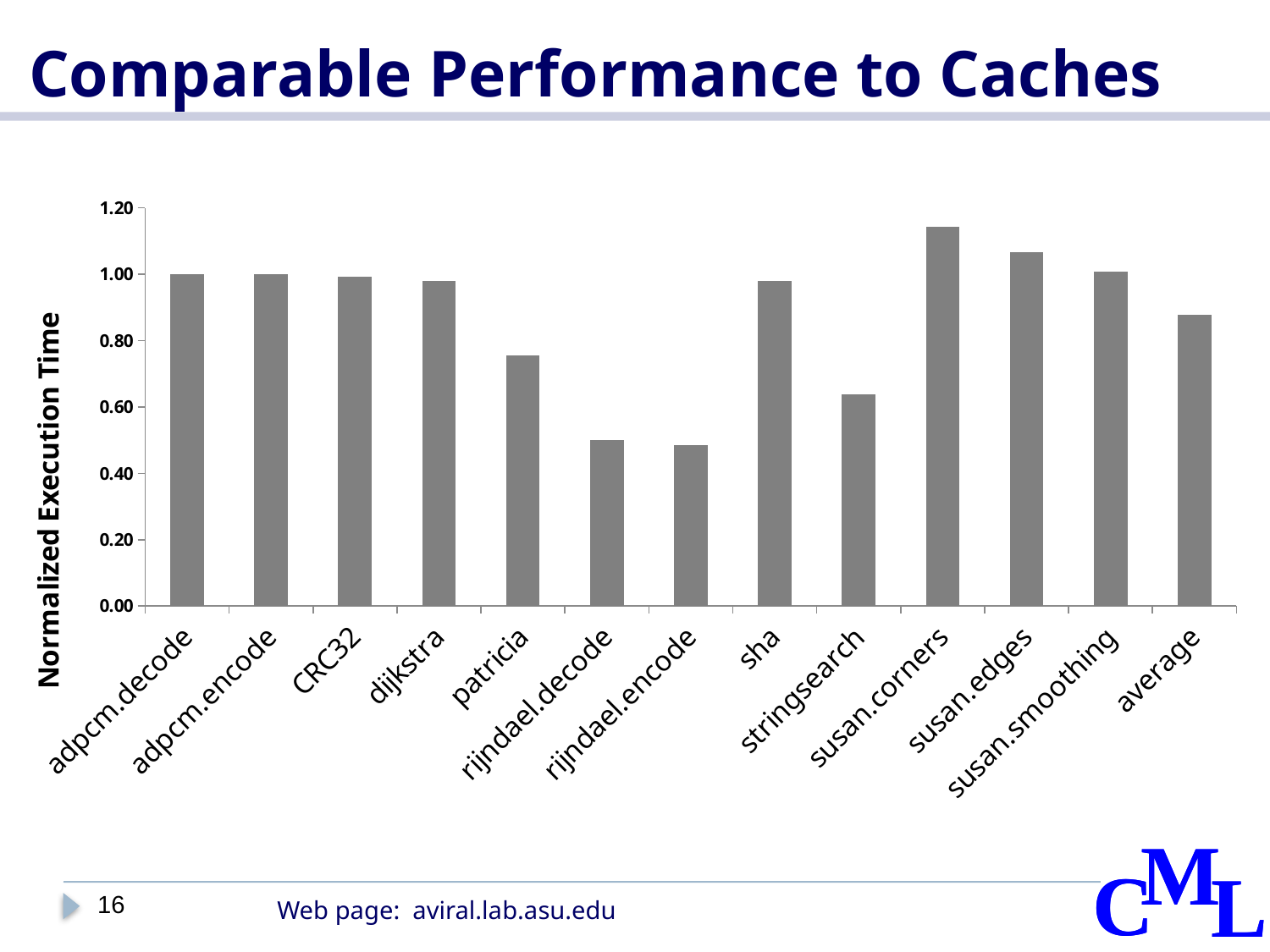
Is the value for rijndael.decode greater or less than 0.60? less Is the value for stringsearch greater or less than 0.60? greater Which is larger, the value for susan.corners or the value for susan.edges? susan.corners Is the value for susan.corners greater or less than 1.00? greater What is the label on the y axis of the chart? Normalized Execution Time How many categories are plotted along the x axis? 13 Which category has the highest normalized execution time? susan.corners Which is larger, the value for patricia or the value for stringsearch? patricia What kind of chart is shown on the slide? bar chart Which is larger, the value for sha or the value for rijndael.encode? sha